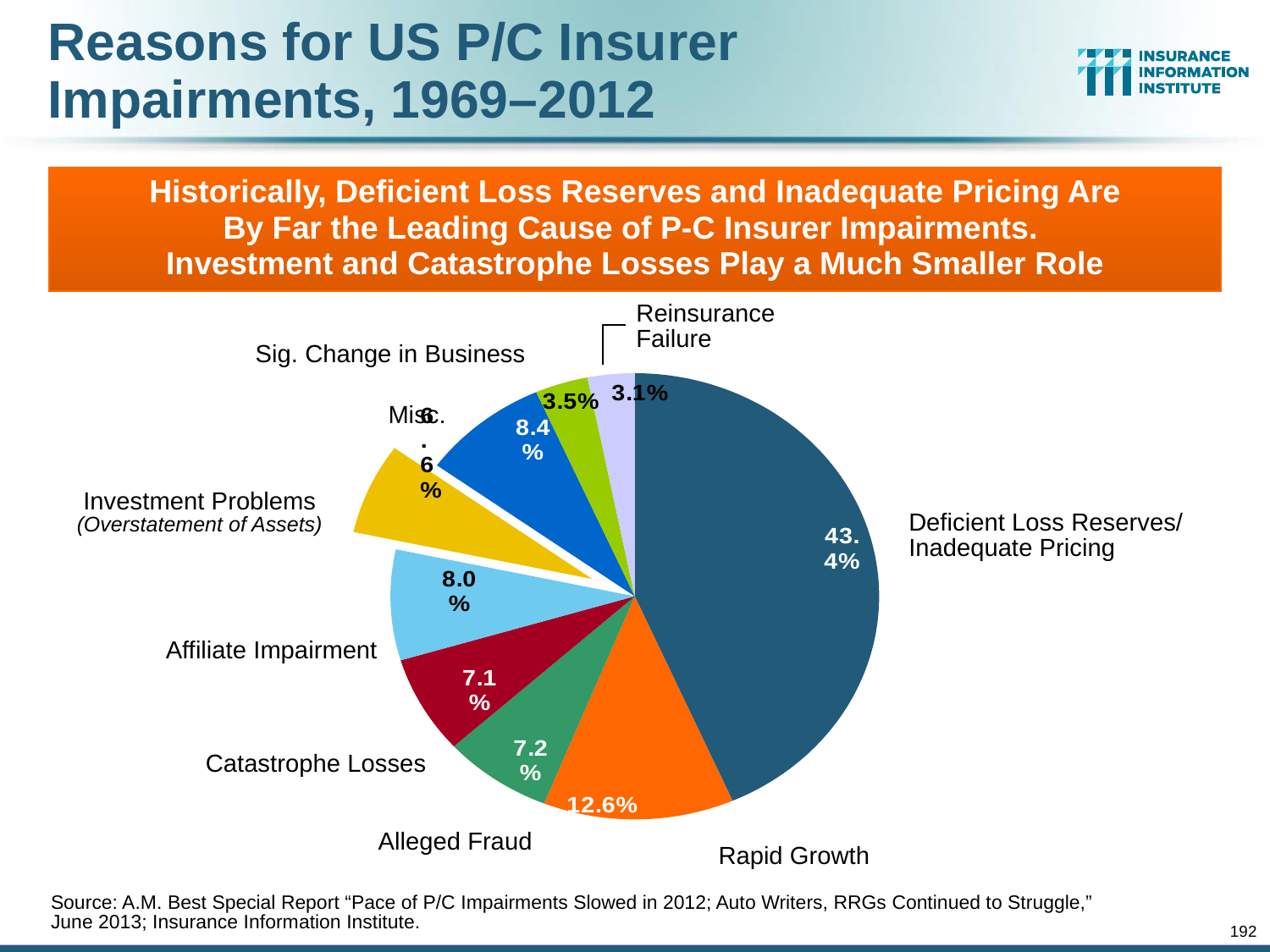
Which reason accounts for the largest share of US P/C insurer impairments? Deficient Loss Reserves/Inadequate Pricing Which has a larger share of impairments, Affiliate Impairment or Catastrophe Losses? Affiliate Impairment What share of impairments is attributed to Deficient Loss Reserves/Inadequate Pricing? 43.4% How many reasons for impairment are shown as slices in the pie chart? 9 By how many percentage points does the Deficient Loss Reserves/Inadequate Pricing share exceed the Rapid Growth share? 30.8 percentage points What share of impairments is attributed to Sig. Change in Business? 3.5% What kind of chart is shown on the slide? pie chart What share of impairments is attributed to Rapid Growth? 12.6% What share of impairments is attributed to Affiliate Impairment? 8.0% What share of impairments is attributed to Catastrophe Losses? 7.1% What share of impairments is attributed to Alleged Fraud? 7.2% Which reason accounts for the smallest share of impairments? Reinsurance Failure